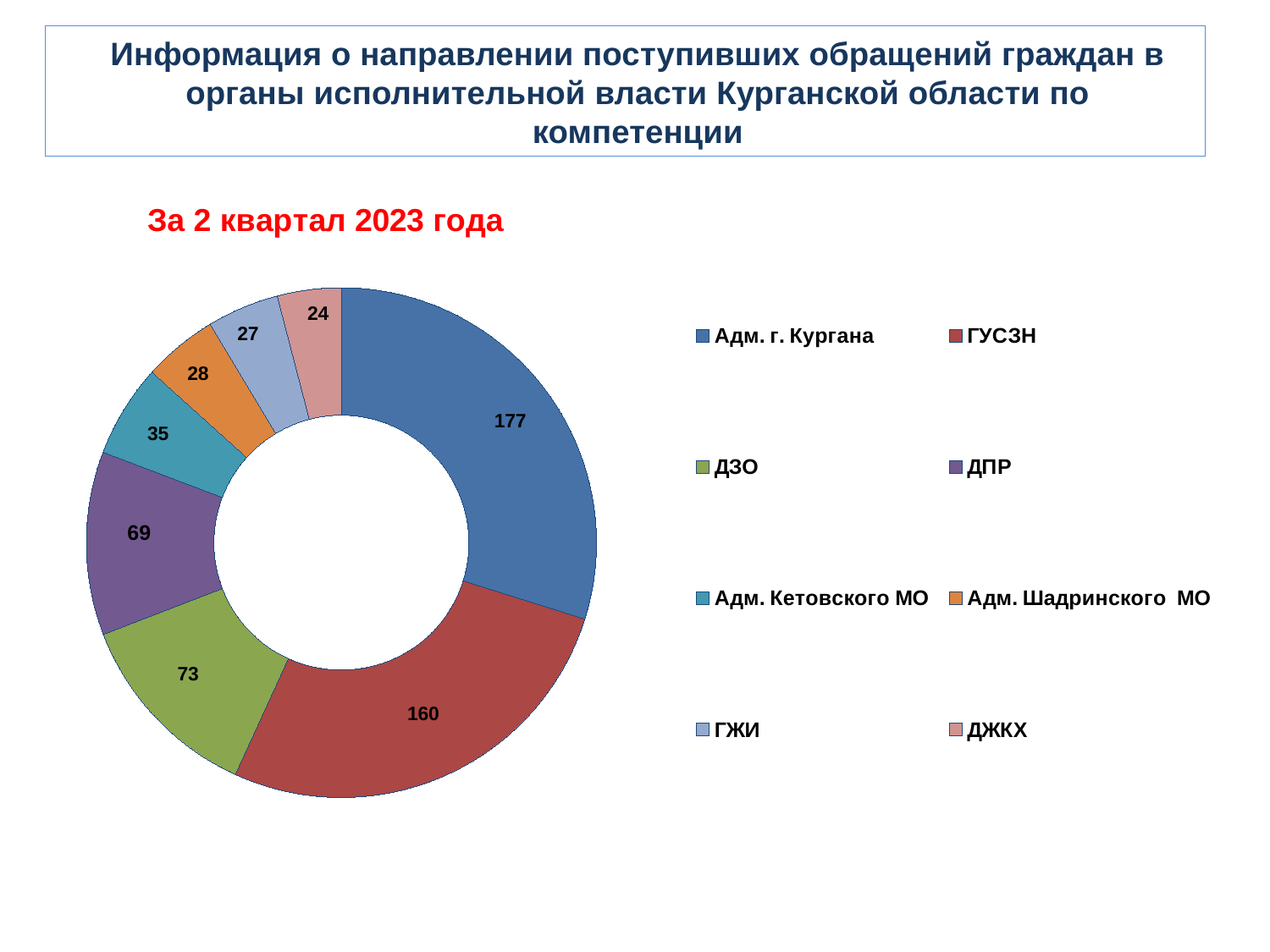
What is the value shown for ГУСЗН? 160 What is the value shown for ДПР? 69 What period does the chart cover, according to the red subtitle? За 2 квартал 2023 года How many appeals were directed to Адм. г. Кургана? 177 How many categories does the chart show? 8 What is the value shown for ГЖИ? 27 What is the difference between the values for ДЗО and ДПР? 4 Which is larger, the value for Адм. Кетовского МО or the value for Адм. Шадринского МО? Адм. Кетовского МО Which category has the largest slice in the chart? Адм. г. Кургана Which category has the smallest slice in the chart? ДЖКХ What kind of chart is shown on the slide? doughnut chart What is the difference between the values for Адм. г. Кургана and ГУСЗН? 17